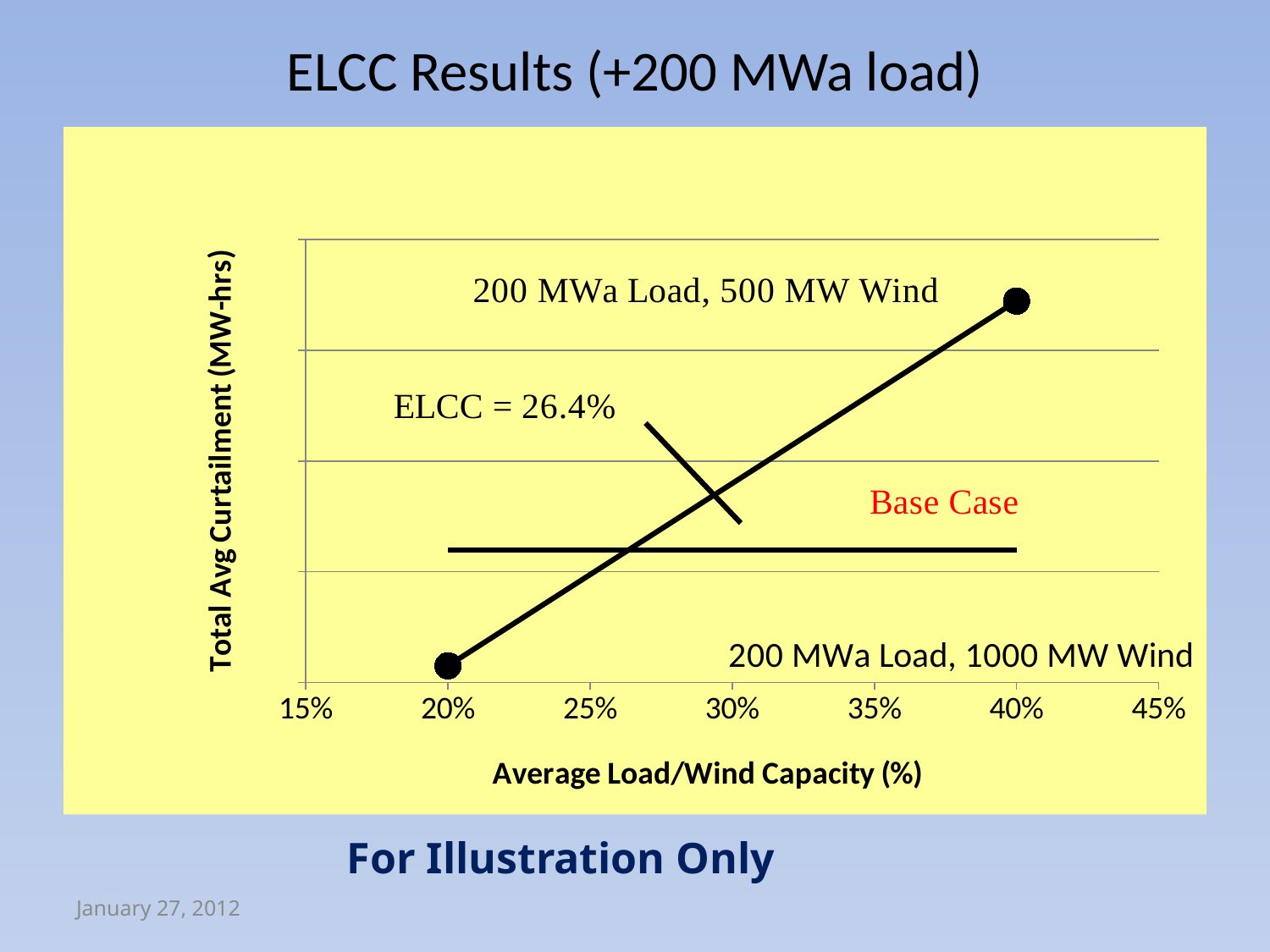
Does total average curtailment rise or fall as Average Load/Wind Capacity increases along the x axis? rise Which plotted point has the higher total average curtailment, the 500 MW Wind point or the 1000 MW Wind point? 200 MWa Load, 500 MW Wind Is the annotated ELCC value greater or less than 25%? greater What is the lowest value shown on the x axis? 15% How many data points are plotted on the sloped line? 2 At what Average Load/Wind Capacity value is the '200 MWa Load, 1000 MW Wind' point plotted? 20% What colour is the 'Base Case' label on the chart? red What ELCC value is annotated on the chart? 26.4% Which plotted point has the lowest total average curtailment? 200 MWa Load, 1000 MW Wind What is the title of the x axis? Average Load/Wind Capacity (%) What kind of chart is shown on the slide? line chart At what Average Load/Wind Capacity value is the '200 MWa Load, 500 MW Wind' point plotted? 40%